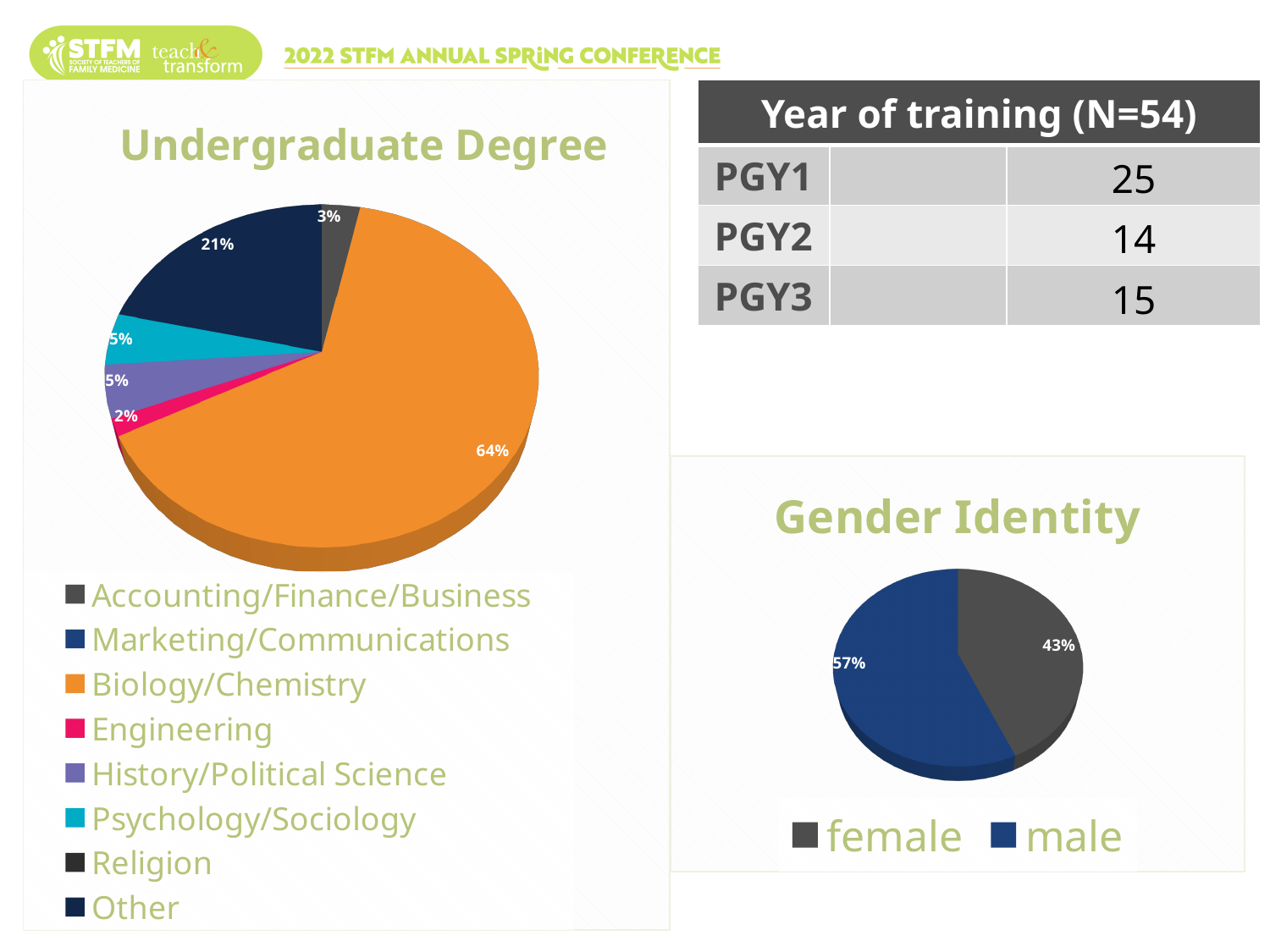
In the Undergraduate Degree chart, what percentage is shown for Psychology/Sociology? 5% In the Gender Identity chart, what percentage is shown for male? 57% What kind of chart is the Undergraduate Degree chart? pie chart How many entries does the legend of the Gender Identity chart list? 2 What kind of chart is the Gender Identity chart? pie chart In the Gender Identity chart, what is the difference in percentage points between male and female? 14 percentage points In the Undergraduate Degree chart, what percentage is shown for Biology/Chemistry? 64% How many categories does the legend of the Undergraduate Degree chart list? 8 In the Gender Identity chart, which slice is larger, female or male? male In the Undergraduate Degree chart, which category has the largest slice? Biology/Chemistry